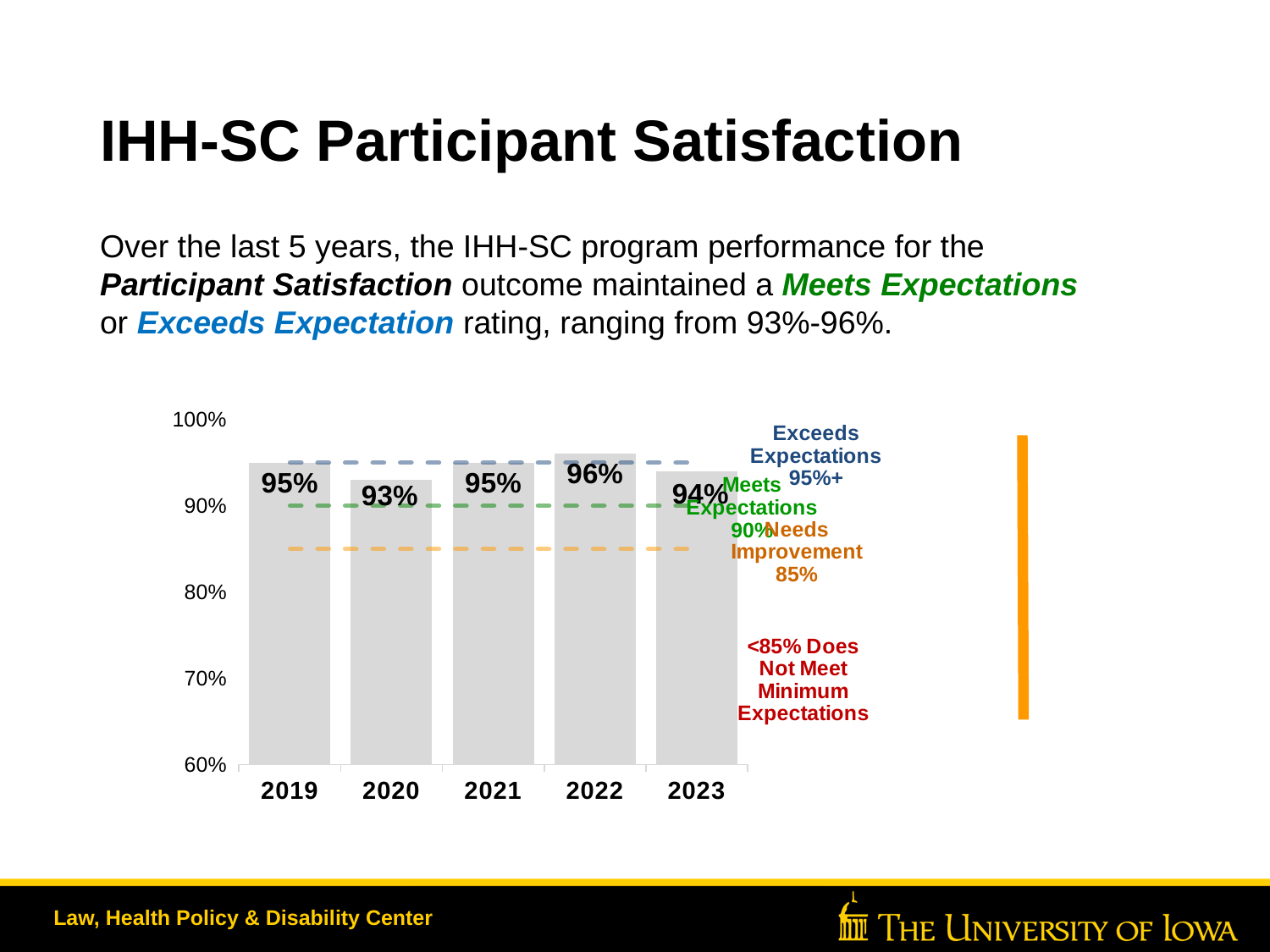
How many years are shown on the x axis of the chart? 5 What is the participant satisfaction value for 2019? 95% What is the participant satisfaction value for 2020? 93% Which year has the highest participant satisfaction value? 2022 What threshold is labelled as 'Exceeds Expectations' on the chart? 95%+ What is the participant satisfaction value for 2023? 94% Which year has a larger participant satisfaction value, 2021 or 2023? 2021 What kind of chart is shown on the slide? bar chart What is the difference between the 2022 and 2020 participant satisfaction values? 3% What is the participant satisfaction value for 2022? 96% Which year has the lowest participant satisfaction value? 2020 Is the value for 2020 greater or less than 90%? greater